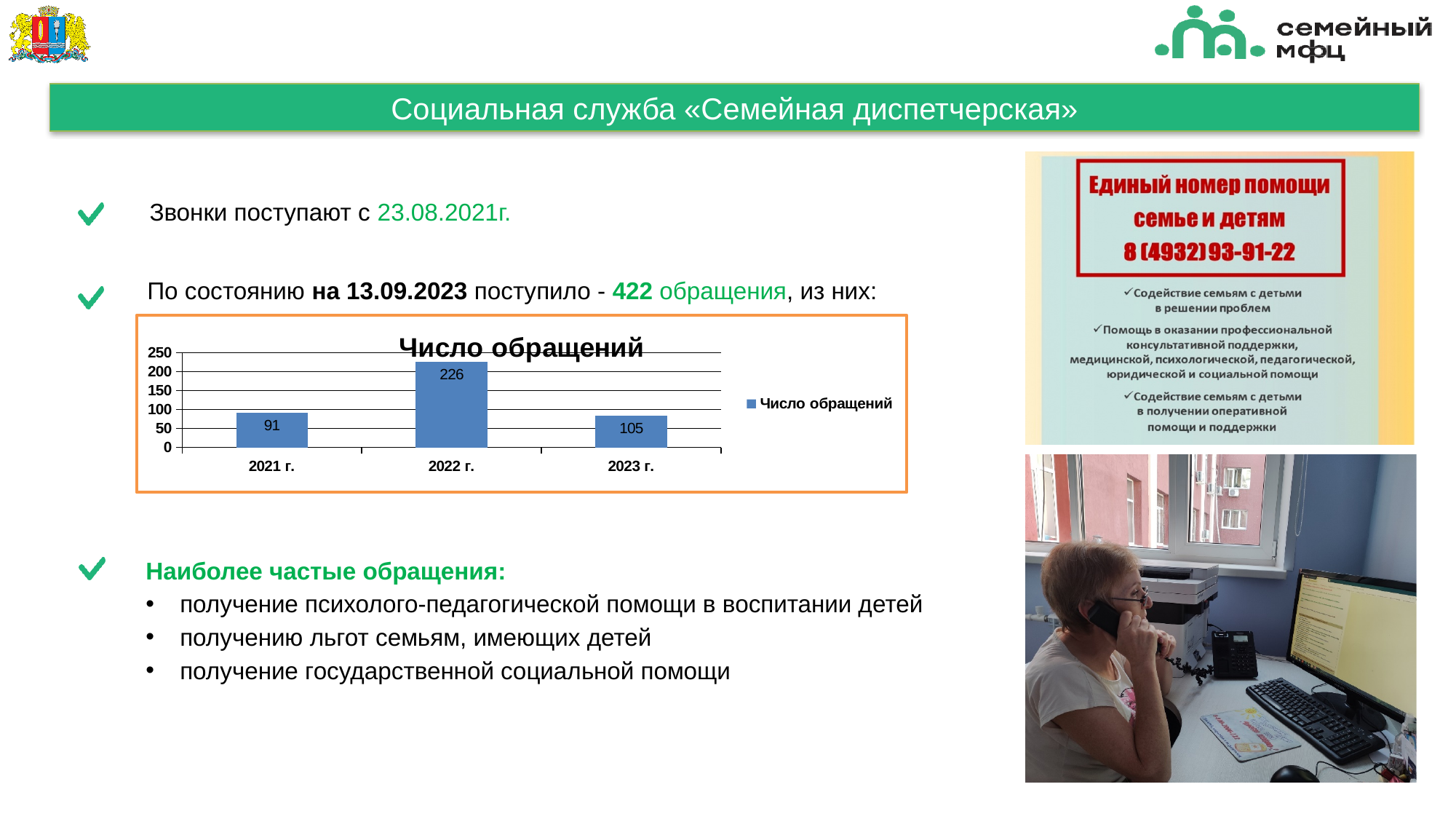
What is the value for 2023 г. in the chart? 105 What kind of chart is shown on the slide? bar chart What is the value for 2022 г. in the chart? 226 Is the value for 2022 г. greater or less than 200? greater What is the difference between the values for 2023 г. and 2021 г.? 14 Which year has the highest number of обращений? 2022 г. What is the title of the chart? Число обращений What is the difference between the values for 2022 г. and 2021 г.? 135 How many years are shown on the x axis of the chart? 3 What is the value for 2021 г. in the chart? 91 Which is larger, the value for 2022 г. or the value for 2023 г.? 2022 г.